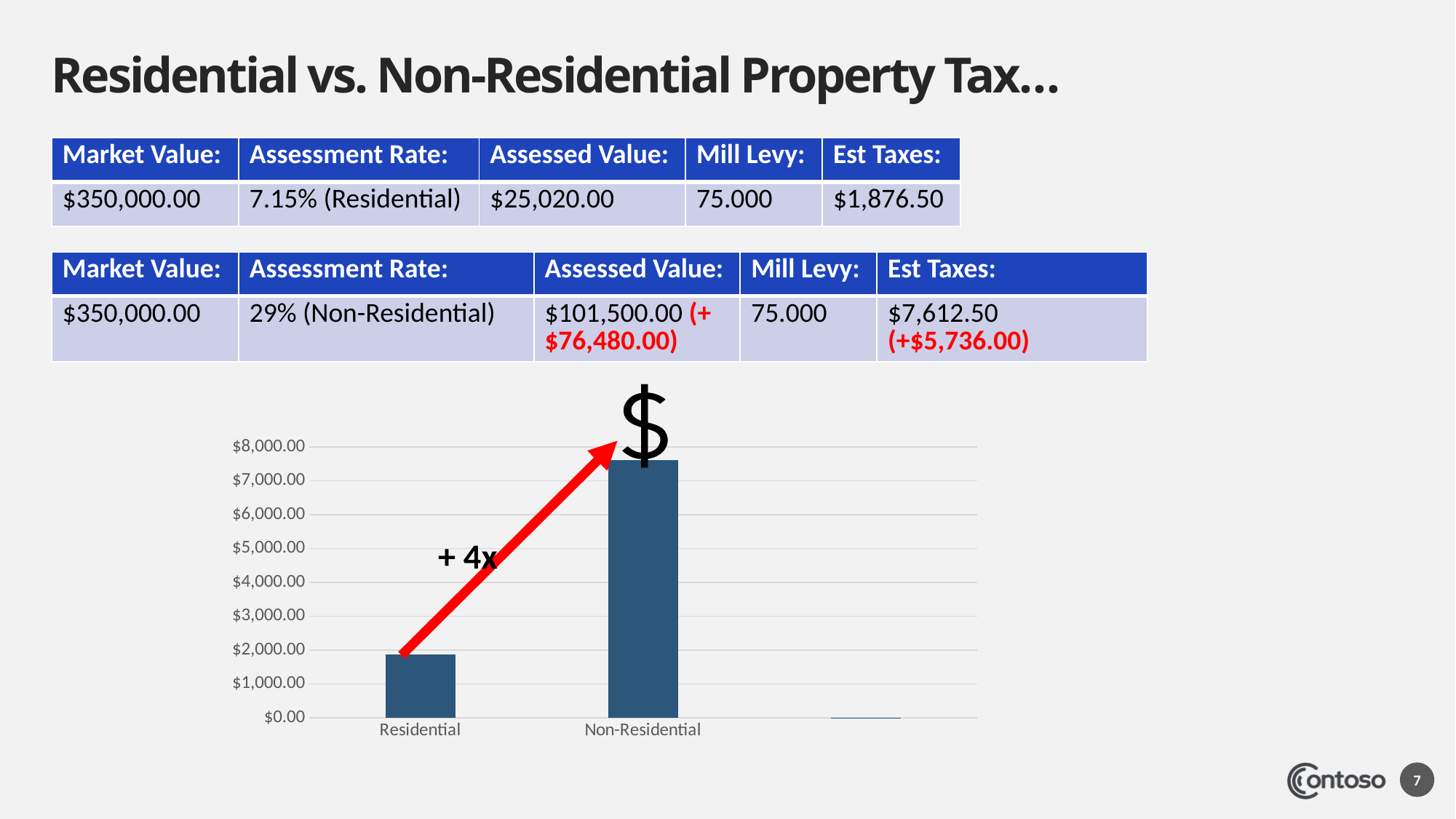
What text is written next to the red arrow on the chart? + 4x Which category has the highest bar in the chart? Non-Residential Is the value for Non-Residential greater or less than $7,000.00? greater What is the highest tick label shown on the chart's vertical axis? $8,000.00 Is the value for Non-Residential greater or less than $8,000.00? less Is the value for Residential greater or less than $2,000.00? less What kind of chart is shown on the slide? bar chart Which bar is taller, Residential or Non-Residential? Non-Residential Do the bar values rise or fall from Residential to Non-Residential? rise